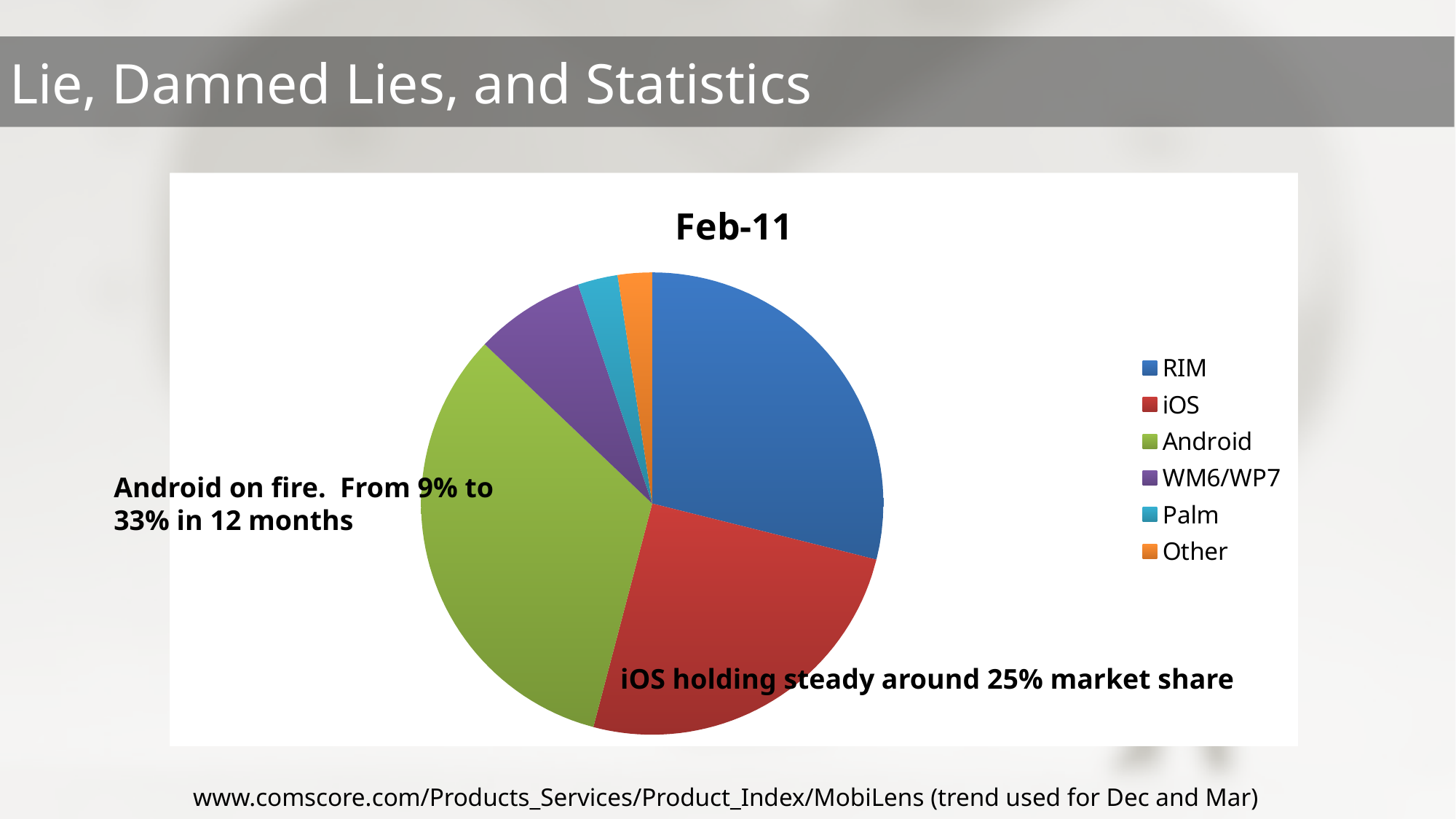
Which is larger in the pie chart, the Android slice or the WM6/WP7 slice? Android What kind of chart is shown on the slide? pie chart How many entries does the legend list? 6 What colour is the Android slice in the pie chart? green How many slices does the pie chart have? 6 Which is larger in the pie chart, the iOS slice or the WM6/WP7 slice? iOS What is the title of the pie chart? Feb-11 Which is larger in the pie chart, the WM6/WP7 slice or the Palm slice? WM6/WP7